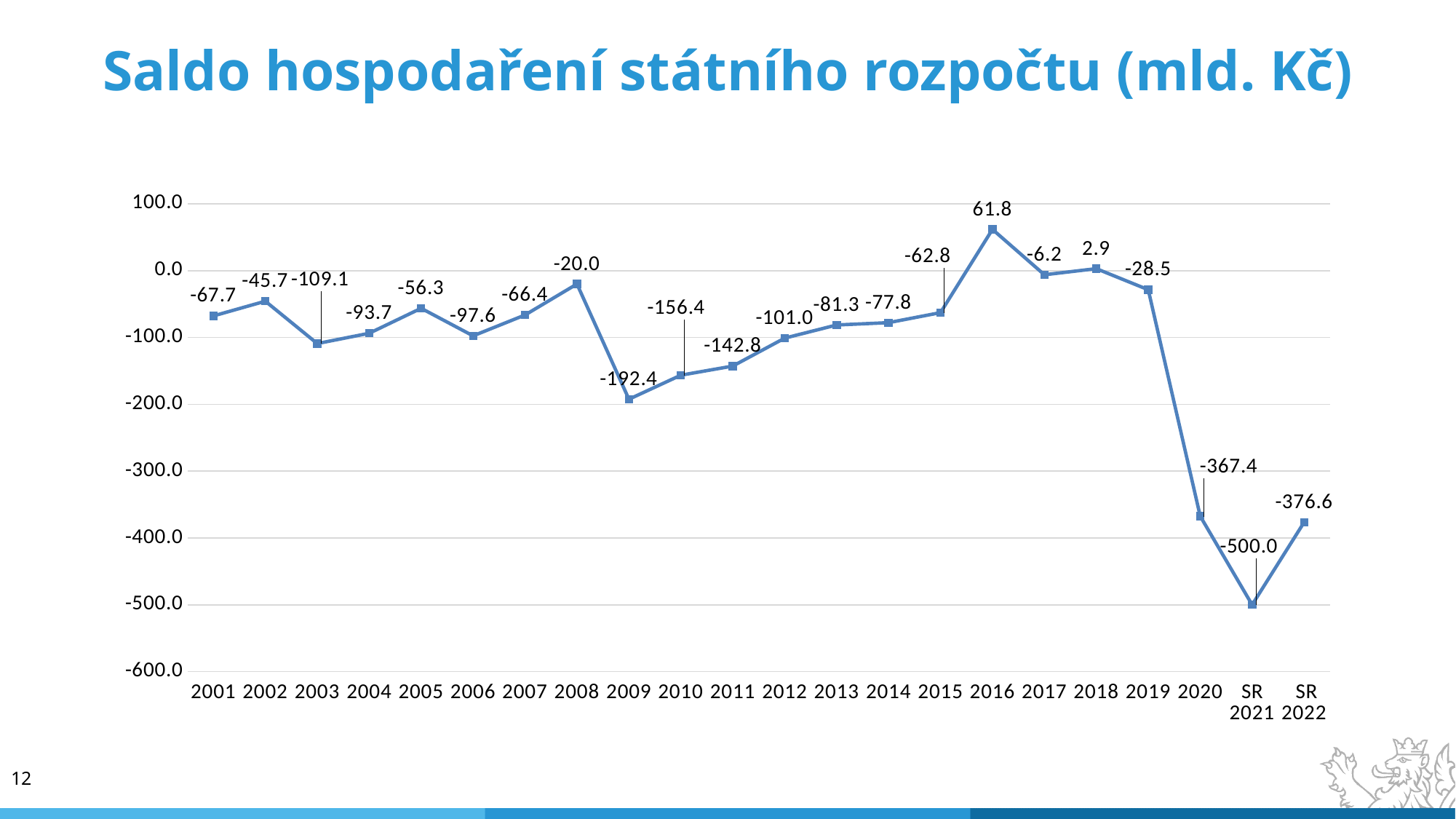
What is the value for 2020? -367.4 What is the difference between the values for 2020 and SR 2021? 132.6 Do the values rise or fall from 2016 to SR 2021? Fall Which category has the lowest value? SR 2021 Which is larger, the value for 2016 or the value for 2018? 2016 What is the value for 2016? 61.8 Which year has the highest value? 2016 What kind of chart is shown on the slide? Line chart What is the value for SR 2021? -500.0 How many data points are plotted on the chart? 22 What is the value for 2009? -192.4 What is the difference between the values for 2008 and 2009? 172.4